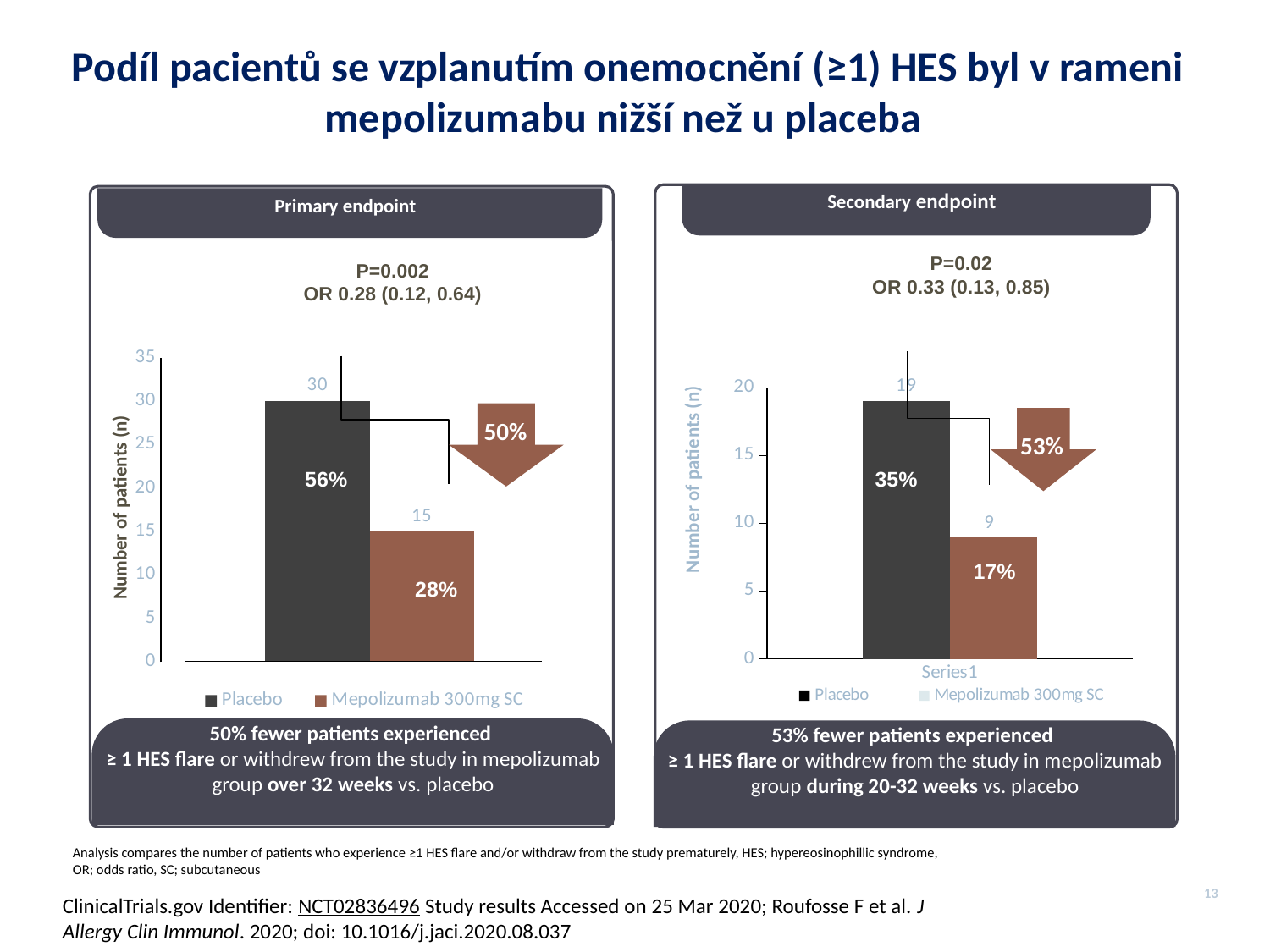
In the Primary endpoint chart, which series has the lowest number of patients? Mepolizumab 300mg SC In the Secondary endpoint chart, which series has the higher number of patients, Placebo or Mepolizumab 300mg SC? Placebo How many series does the legend of the Secondary endpoint chart list? 2 In the Secondary endpoint chart, what is the difference in number of patients between Placebo and Mepolizumab 300mg SC? 10 In the Primary endpoint chart, what is the number of patients for Placebo? 30 In the Secondary endpoint chart, what percentage is printed inside the Mepolizumab 300mg SC bar? 17% In the Secondary endpoint chart, what is the number of patients for Placebo? 19 What kind of chart is the Primary endpoint chart? Bar chart In the Primary endpoint chart, what is the number of patients for Mepolizumab 300mg SC? 15 In the Secondary endpoint chart, what is the number of patients for Mepolizumab 300mg SC? 9 In the Primary endpoint chart, what is the difference in number of patients between Placebo and Mepolizumab 300mg SC? 15 In the Primary endpoint chart, what percentage is printed inside the Placebo bar? 56%